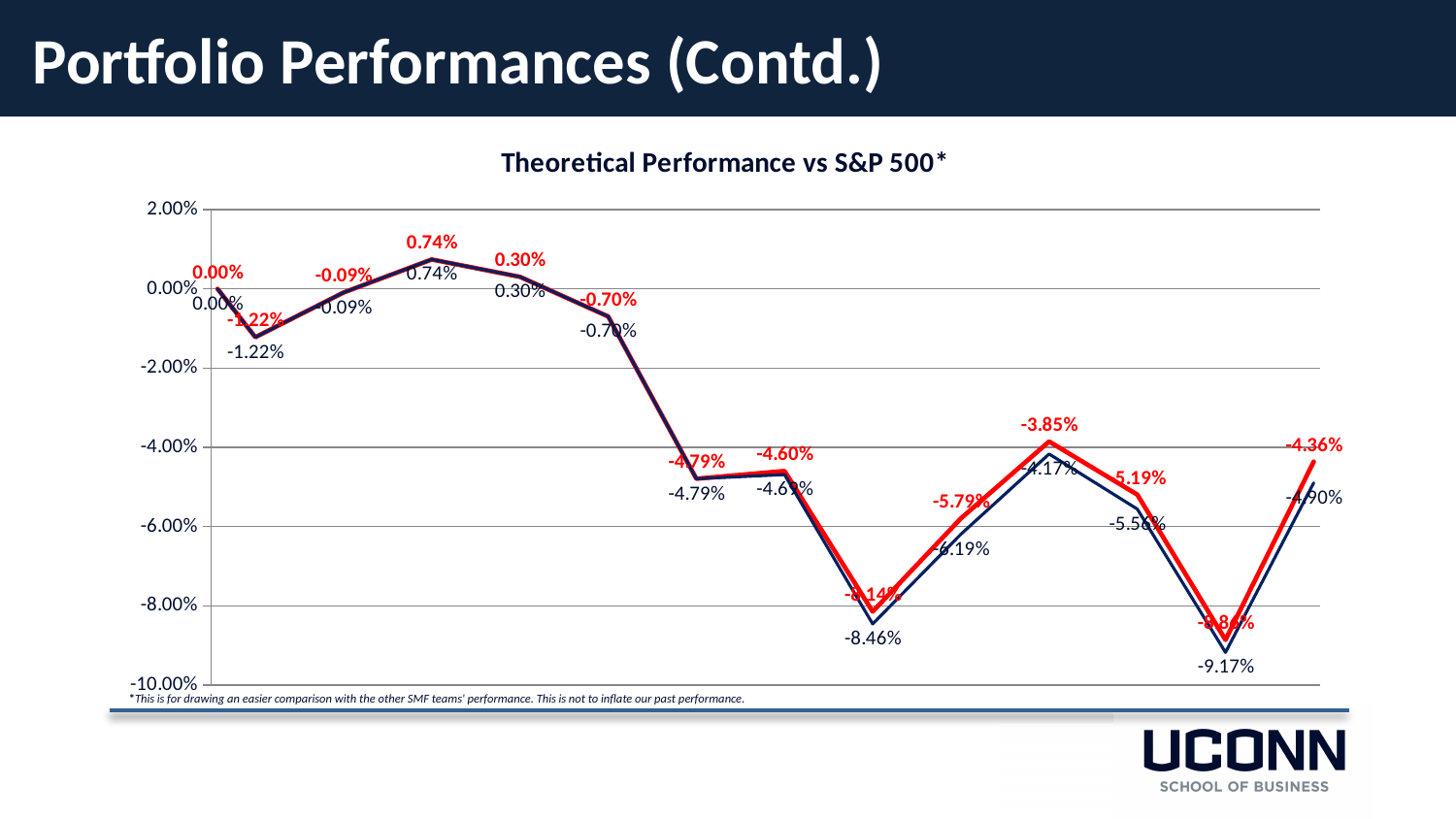
What is the difference between the last point of the red line (-4.36%) and the last point of the dark blue line (-4.90%)? 0.54% What is the lowest value labelled on the dark blue line? -9.17% How many data points does each line on the chart have? 14 What is the value of the last point on the dark blue line? -4.90% What type of chart is shown on the slide? line chart At the final point on the chart, which line is higher, the red line or the dark blue line? red line Is the lowest point of the red line greater or less than -8.00%? less Overall, do the values on the chart rise or fall from the first point to the last point? fall What is the title of the chart? Theoretical Performance vs S&P 500* What is the value of the last point on the red line? -4.36% What is the highest value labelled on the chart? 0.74% How many lines (series) are plotted on the chart? 2